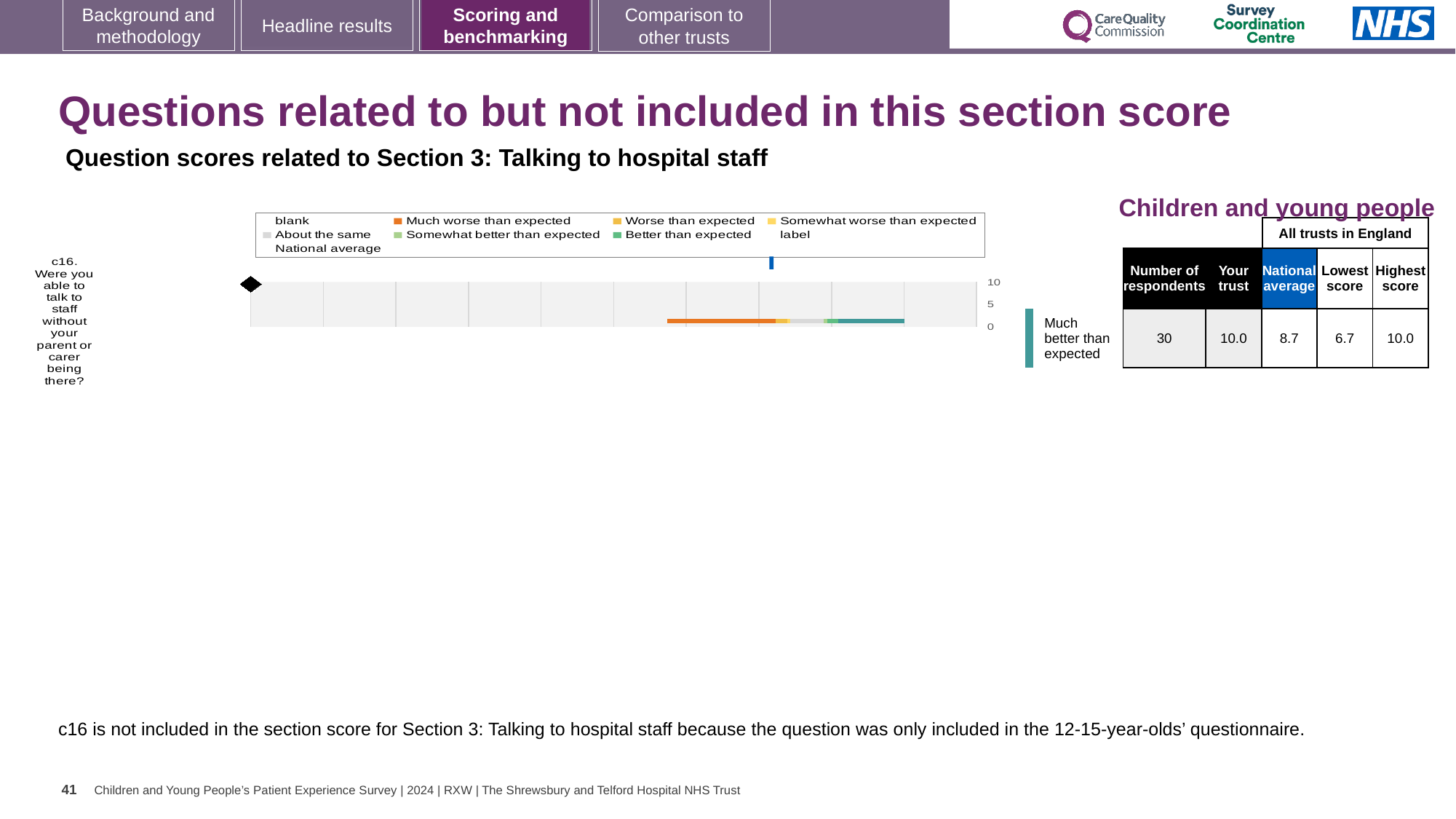
According to the table beside the chart, what is the lowest score among all trusts in England for question c16? 6.7 For question c16, what is the difference between the highest score and the lowest score among all trusts in England? 3.3 What is the highest value shown on the chart's numeric axis? 10 What benchmark label is shown to the right of the chart for question c16? Much better than expected According to the table beside the chart, what is the 'Your trust' score for question c16? 10.0 For question c16, which is larger: the 'Your trust' score or the national average? Your trust According to the table beside the chart, how many respondents answered question c16? 30 According to the table beside the chart, what is the highest score among all trusts in England for question c16? 10.0 For question c16, what is the difference between the 'Your trust' score and the national average? 1.3 How many survey questions are plotted in the chart? 1 What kind of chart is shown on the slide for question c16? bar chart According to the table beside the chart, what is the national average score for question c16? 8.7